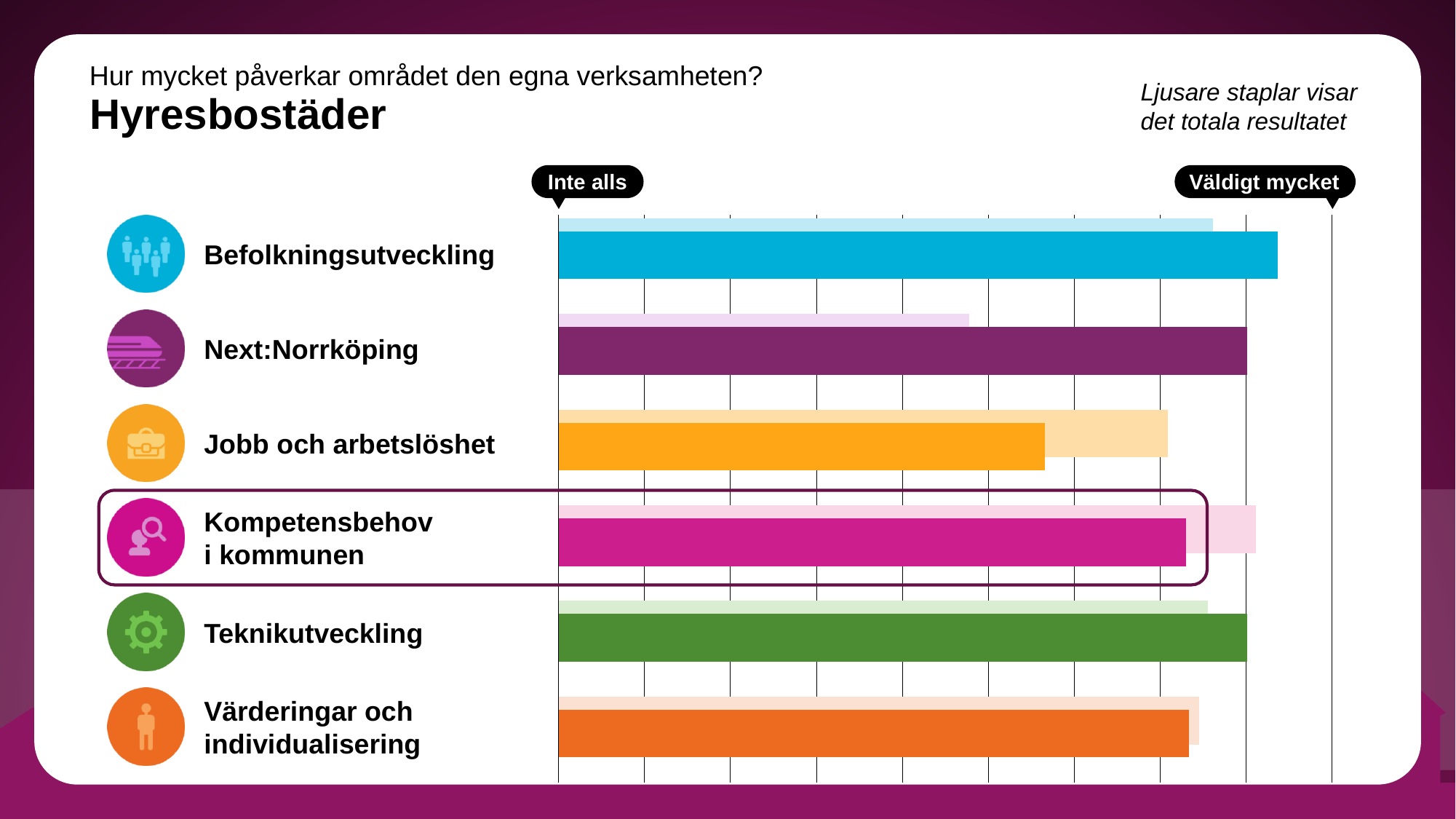
Which category has the longest dark bar (the Hyresbostäder result)? Befolkningsutveckling Which has a longer dark bar, Befolkningsutveckling or Jobb och arbetslöshet? Befolkningsutveckling For Jobb och arbetslöshet, which bar is longer, the dark bar or the light bar? The light bar What do the lighter bars in the chart represent, according to the slide? Det totala resultatet How many categories (areas) are shown in the chart? 6 What kind of chart is shown on the slide? Bar chart Which category has the shortest light bar (the total result)? Next:Norrköping Which has a longer dark bar, Teknikutveckling or Jobb och arbetslöshet? Teknikutveckling Which category has the shortest dark bar (the Hyresbostäder result)? Jobb och arbetslöshet What are the two labels at the ends of the chart's axis? Inte alls and Väldigt mycket